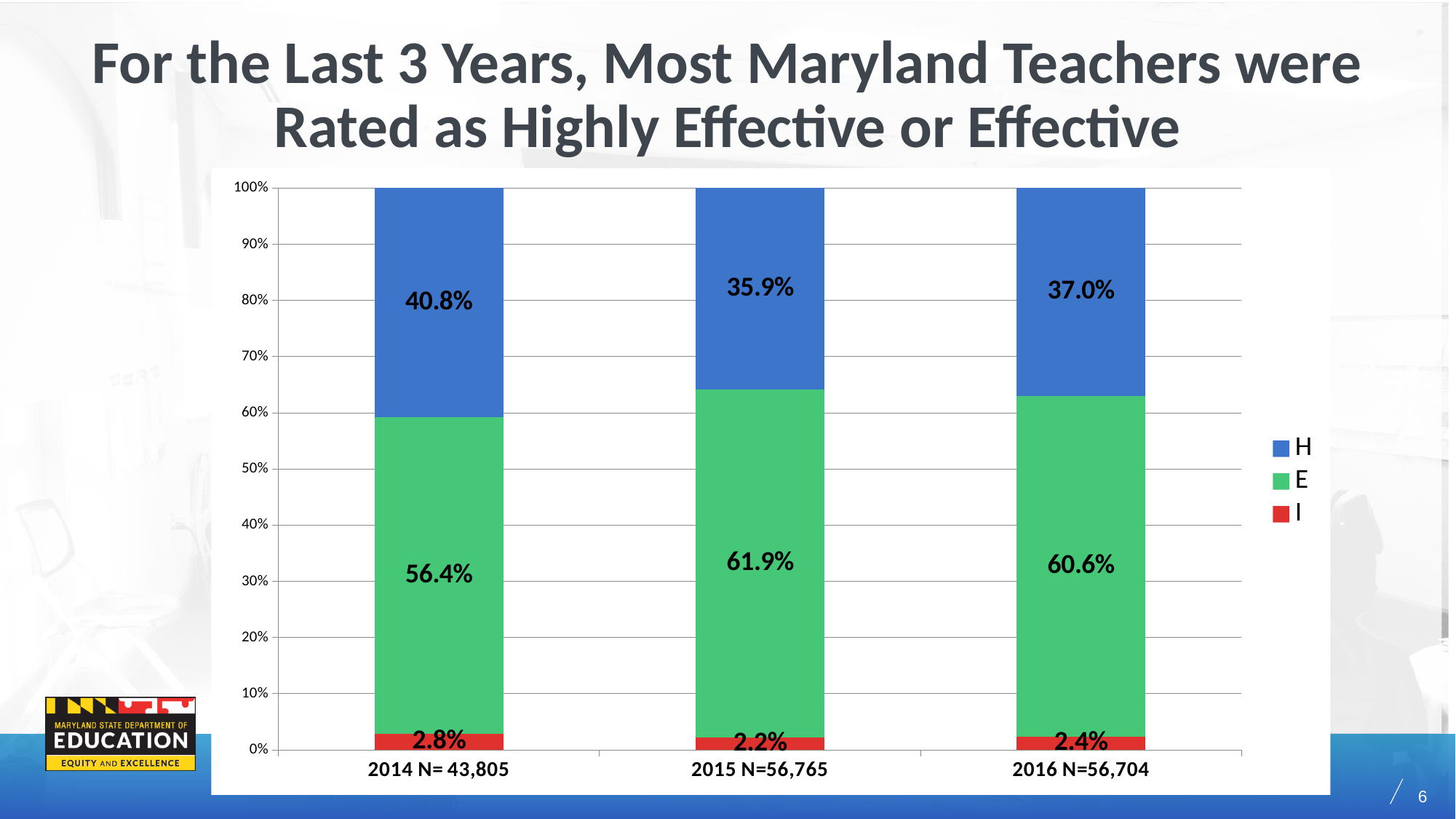
What colour represents the I rating in the chart? Red What kind of chart is shown on the slide? Stacked bar chart Does the percentage of teachers rated E rise or fall from 2014 to 2015? Rise In which year was the share of teachers rated H the highest? 2014 N= 43,805 What is the difference between the E percentage in 2015 and the E percentage in 2014? 5.5% Which is larger: the H percentage in 2016 or the H percentage in 2015? 2016 (37.0%) What percentage of teachers were rated I in 2016? 2.4% How many years (bars) are shown in the chart? 3 What percentage of teachers were rated E (Effective) in 2015? 61.9% In which year was the share of teachers rated I the lowest? 2015 N=56,765 What percentage of teachers were rated H (Highly Effective) in 2014? 40.8% How many series does the legend list? 3